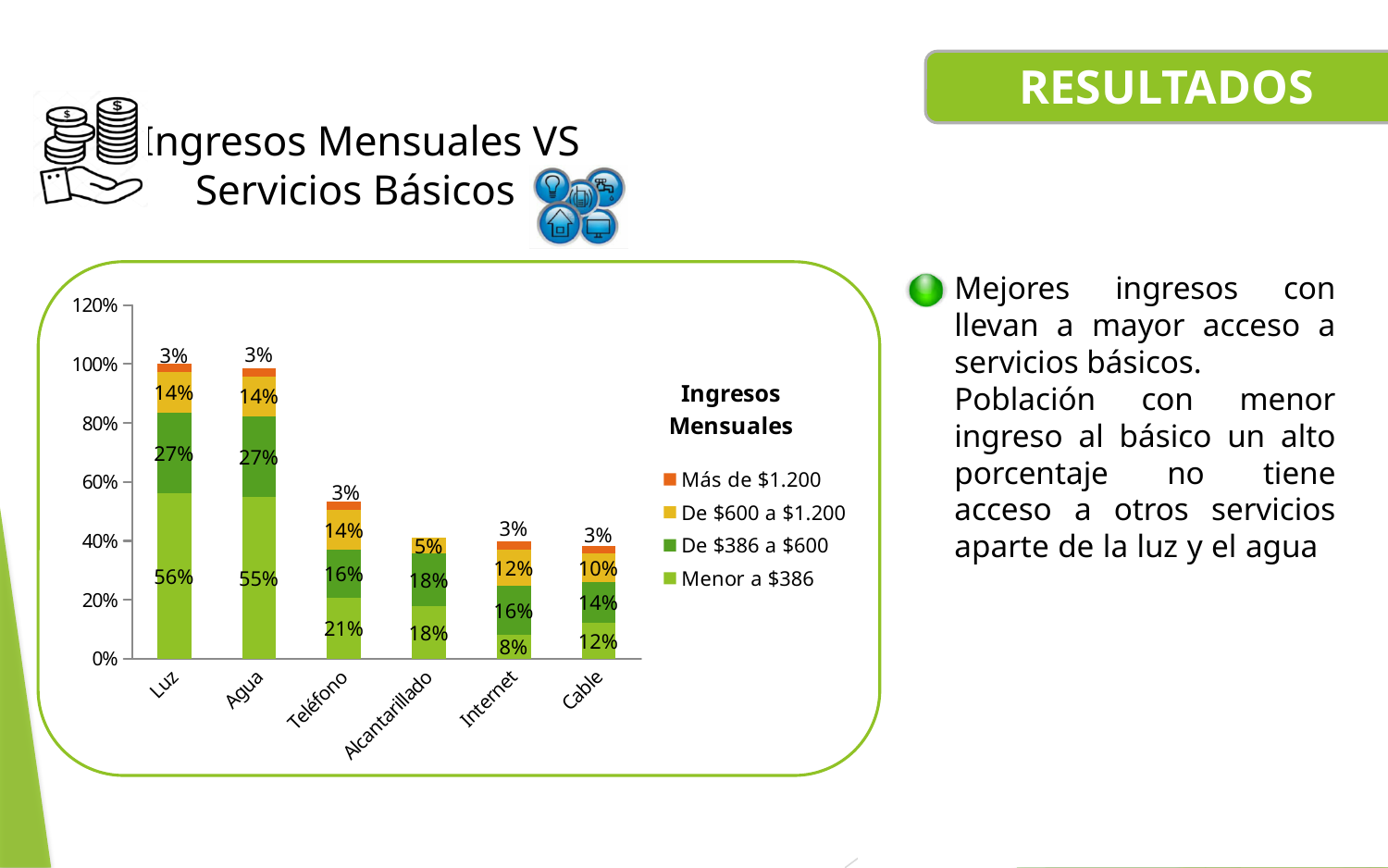
What is the title shown above the legend? Ingresos Mensuales What is the value of the 'De $386 a $600' segment for Teléfono? 16% How many categories are shown on the x axis? 6 What is the total of the stacked bar for Teléfono? 54% Which has the larger 'De $600 a $1.200' value, Teléfono or Alcantarillado? Teléfono What is the value of the 'Menor a $386' segment for Luz? 56% How many series does the legend list? 4 What kind of chart is shown on the slide? Stacked bar chart What is the value of the 'Menor a $386' segment for Internet? 8% What is the difference between the 'Menor a $386' values for Luz and Cable? 44% Which category has the highest value for 'Menor a $386'? Luz Which category has the lowest value for 'Menor a $386'? Internet